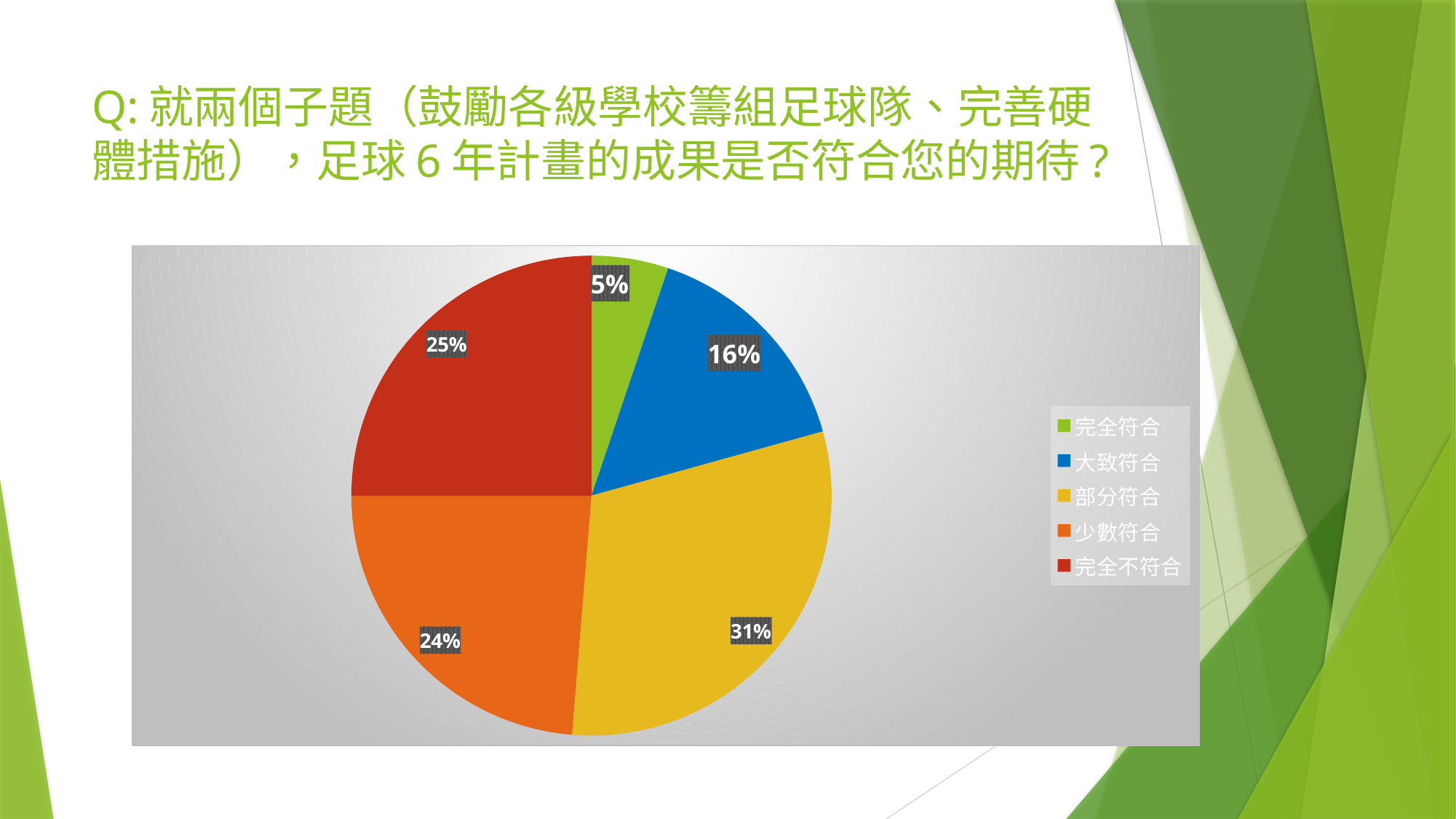
How many categories does the legend list? 5 What percentage of the pie is 完全符合? 5% What kind of chart is shown on the slide? pie chart Which is larger, the share for 完全不符合 or the share for 大致符合? 完全不符合 What percentage of the pie is 大致符合? 16% What is the difference in percentage points between 部分符合 and 大致符合? 15 What percentage of the pie is 完全不符合? 25% Which category has the smallest share of the pie? 完全符合 Which category has the largest share of the pie? 部分符合 What colour is the slice for 部分符合? yellow What percentage of the pie is 少數符合? 24% What percentage of the pie is 部分符合? 31%